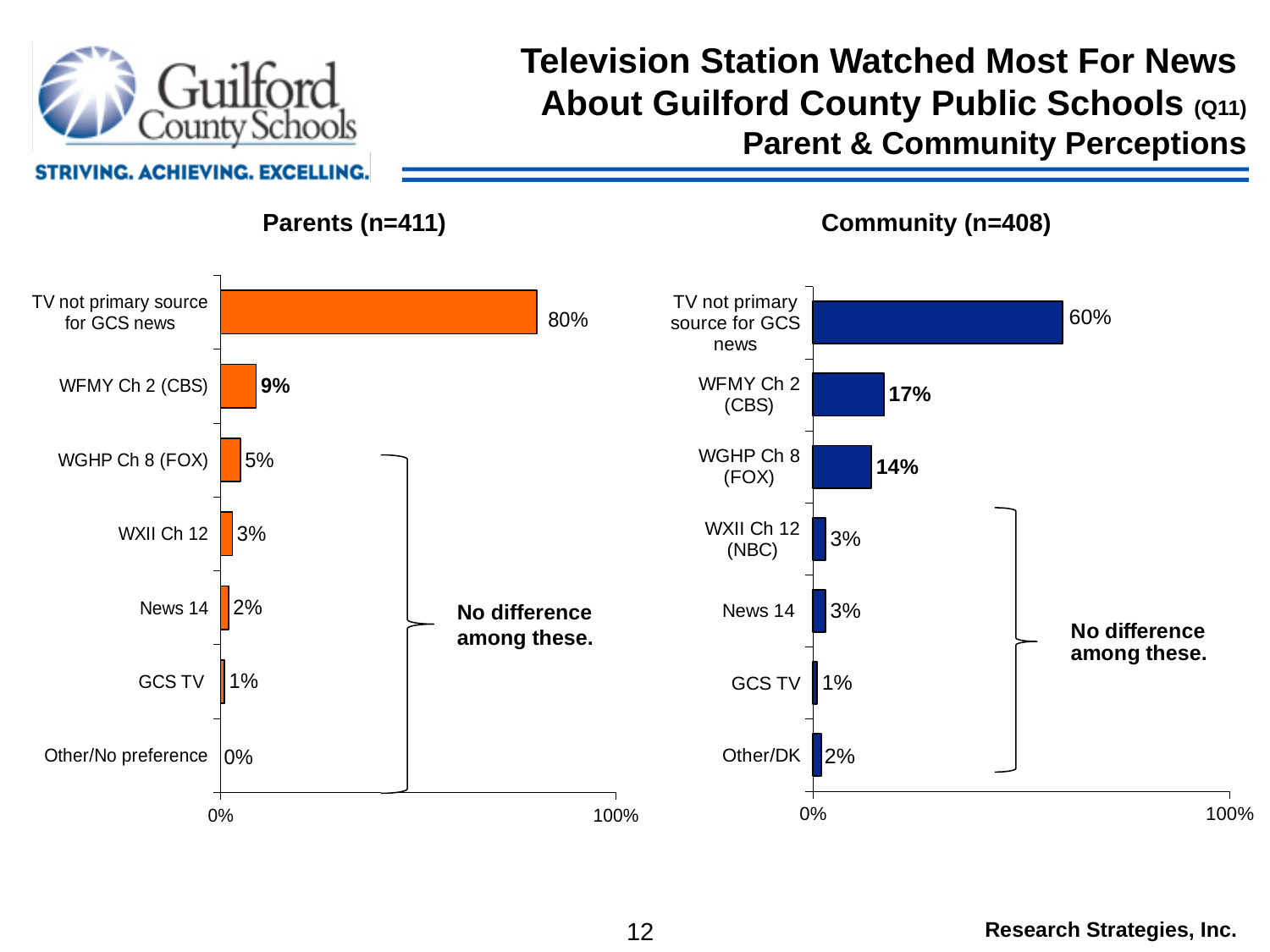
In the Parents (n=411) chart, what percentage is shown for WGHP Ch 8 (FOX)? 5% In the Community (n=408) chart, what percentage is shown for Other/DK? 2% How many categories are shown in the Community (n=408) chart? 7 In the Community (n=408) chart, what percentage is shown for WFMY Ch 2 (CBS)? 17% In the Parents (n=411) chart, what is the difference between 'TV not primary source for GCS news' and WFMY Ch 2 (CBS)? 71% Which is larger: the WFMY Ch 2 (CBS) value in the Parents chart or the WFMY Ch 2 (CBS) value in the Community chart? Community chart In the Parents (n=411) chart, what percentage is shown for 'TV not primary source for GCS news'? 80% In the Community (n=408) chart, which category has the highest value? TV not primary source for GCS news What colour are the bars in the Parents (n=411) chart? Orange In the Parents (n=411) chart, which category has the lowest value? Other/No preference What type of chart is the Parents (n=411) chart? Bar chart In the Community (n=408) chart, what is the difference between WFMY Ch 2 (CBS) and WGHP Ch 8 (FOX)? 3%